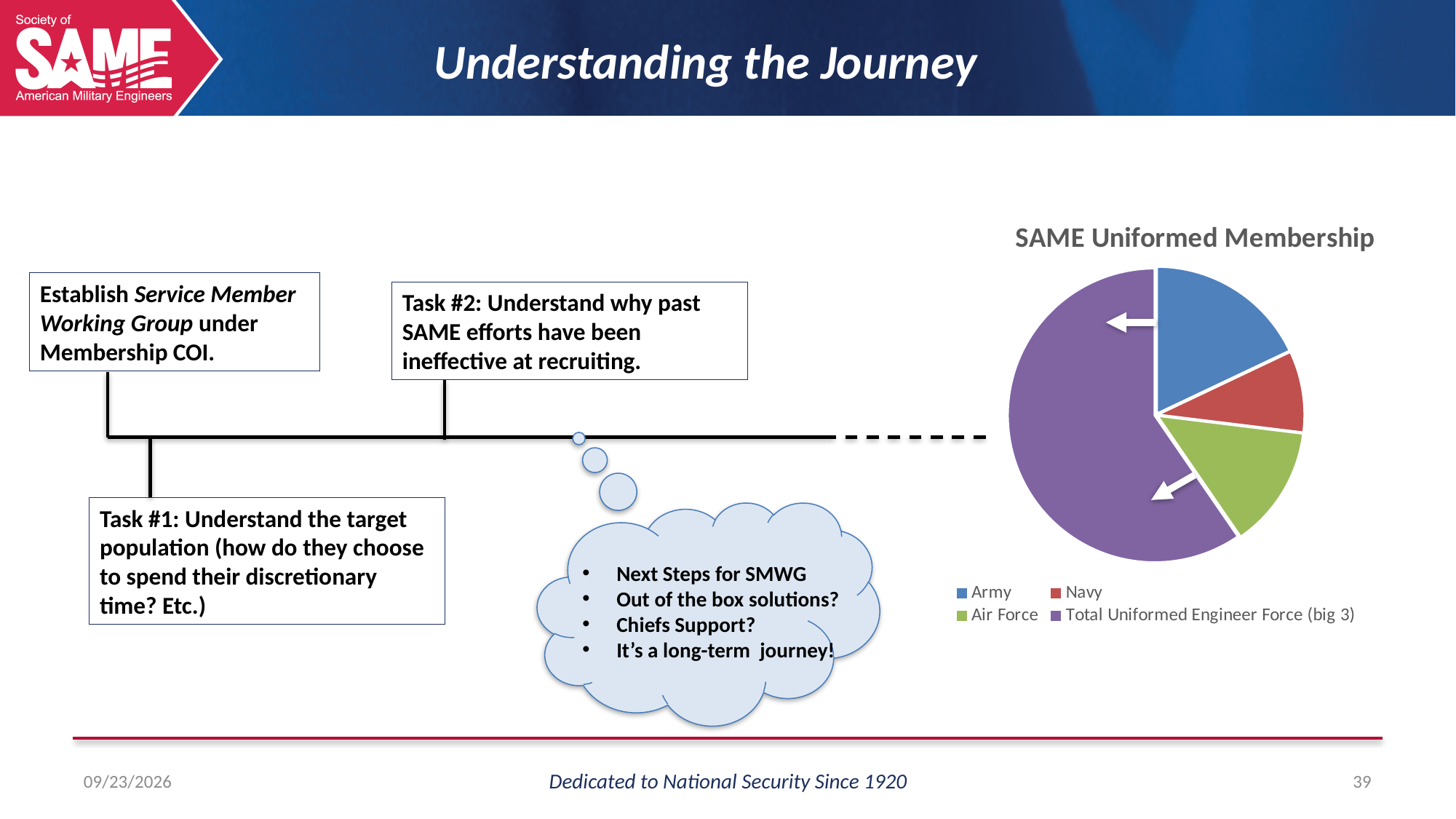
What kind of chart is shown on the slide? Pie chart Which category has the smallest slice in the pie chart? Navy What is the title of the pie chart? SAME Uniformed Membership Which slice is larger in the pie chart, Air Force or Navy? Air Force How many slices does the pie chart have? 4 Which slice is larger in the pie chart, Total Uniformed Engineer Force (big 3) or Army? Total Uniformed Engineer Force (big 3) What colour is the Army slice in the pie chart? Blue Which category has the largest slice in the pie chart? Total Uniformed Engineer Force (big 3) How many entries does the legend of the pie chart list? 4 Which slice is larger in the pie chart, Army or Navy? Army